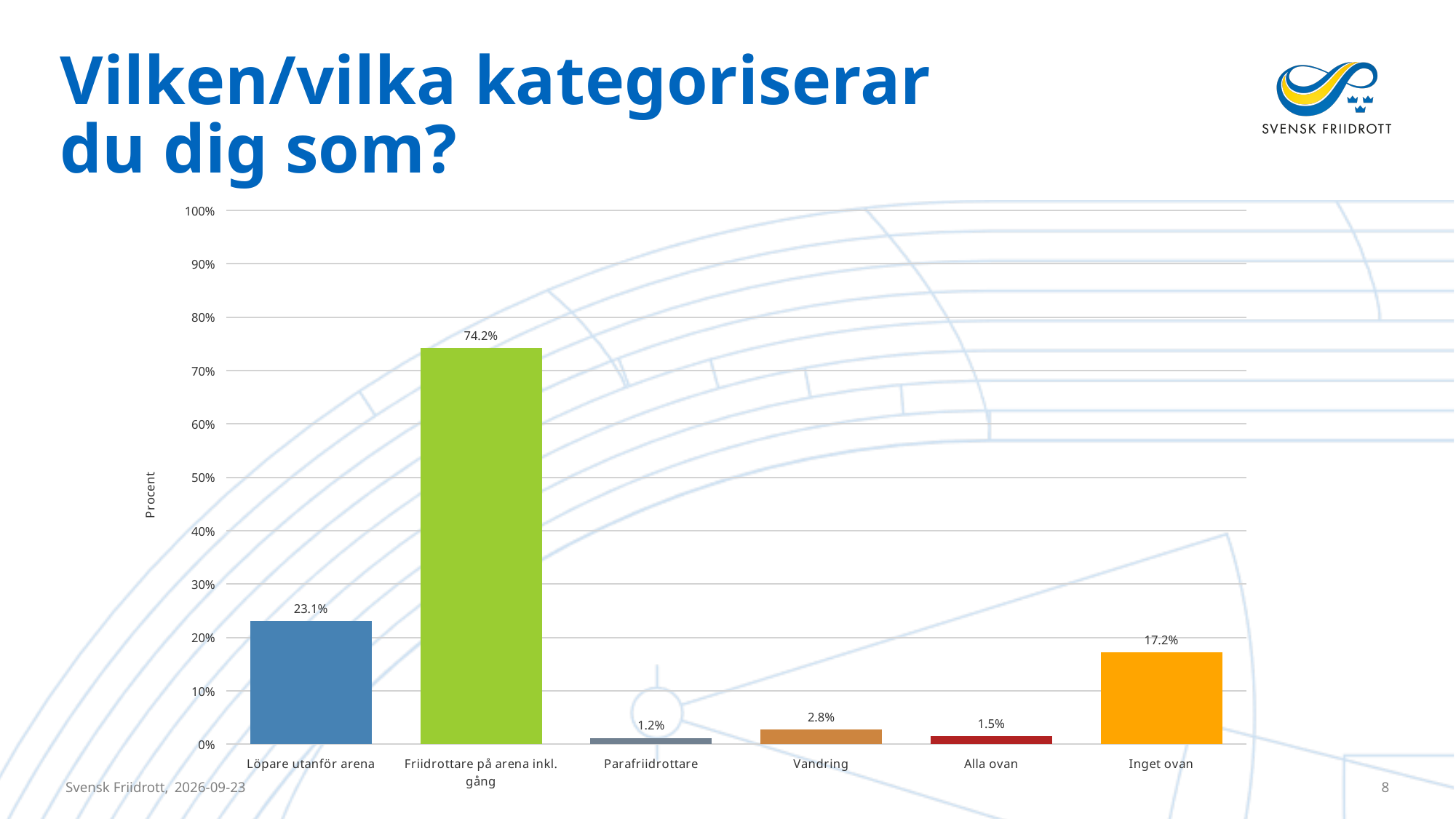
What is the difference between the values for Friidrottare på arena inkl. gång and Löpare utanför arena? 51.1% What is the value for Friidrottare på arena inkl. gång? 74.2% Is the value for Friidrottare på arena inkl. gång greater or less than 70%? greater What kind of chart is shown on the slide? bar chart Which category has the highest value? Friidrottare på arena inkl. gång Which is larger, the value for Löpare utanför arena or the value for Inget ovan? Löpare utanför arena What is the value for Löpare utanför arena? 23.1% What is the value for Inget ovan? 17.2% How many categories are shown on the x axis? 6 What is the label of the vertical axis? Procent What is the value for Vandring? 2.8% Which category has the lowest value? Parafriidrottare